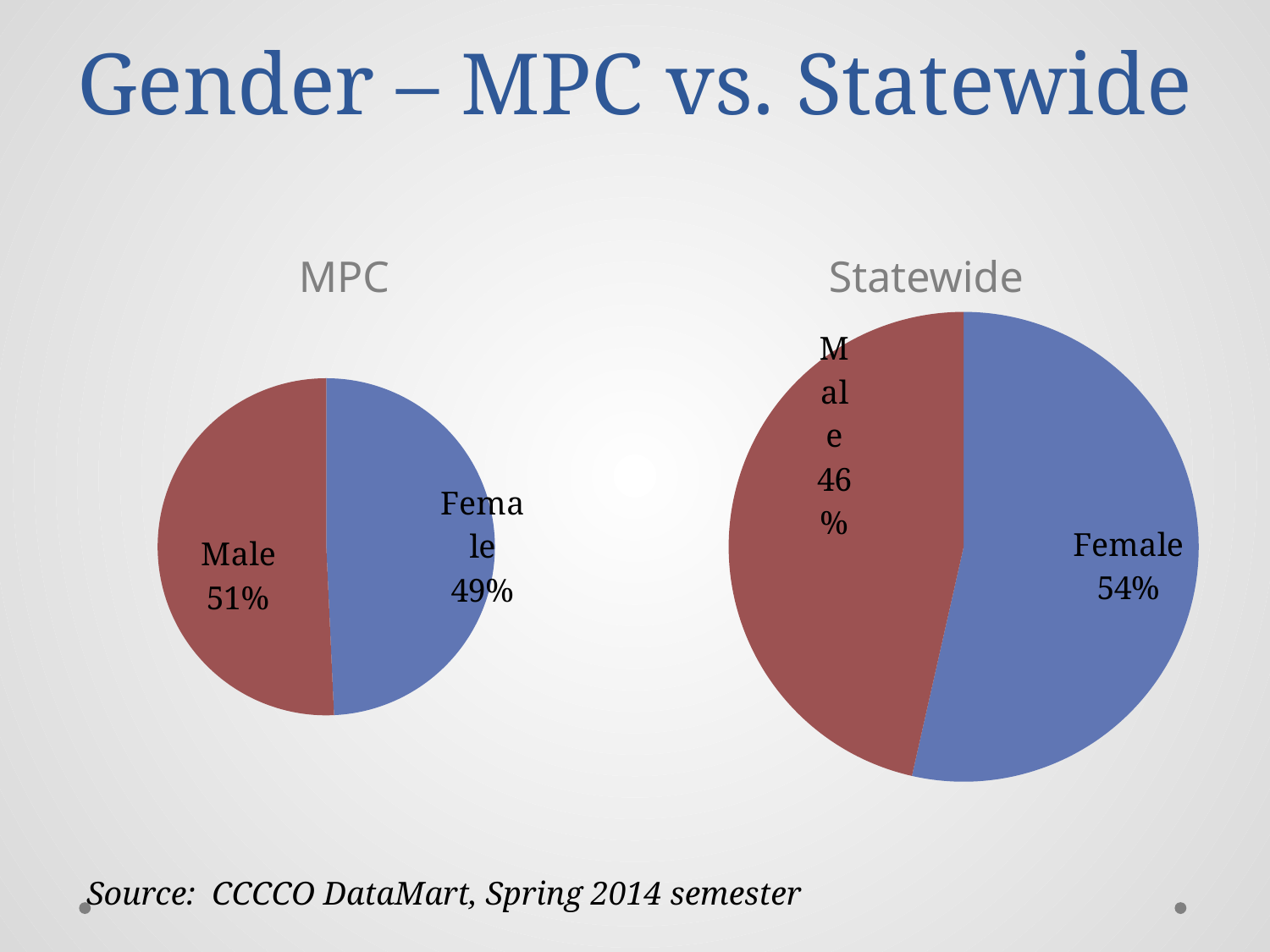
In the MPC chart, what percentage is Male? 51% In the MPC chart, what percentage is Female? 49% In the Statewide chart, which slice is larger, Male or Female? Female In the Statewide chart, which slice is the smallest? Male What is the title of the chart on the right? Statewide In the MPC chart, what is the difference between the Male and Female percentages? 2% In the Statewide chart, what is the difference between the Female and Male percentages? 8% How many slices does the Statewide chart have? 2 In the Statewide chart, what percentage is Female? 54% What kind of chart is the MPC chart? Pie chart In the Statewide chart, what percentage is Male? 46% In the MPC chart, what colour is the Female slice? Blue